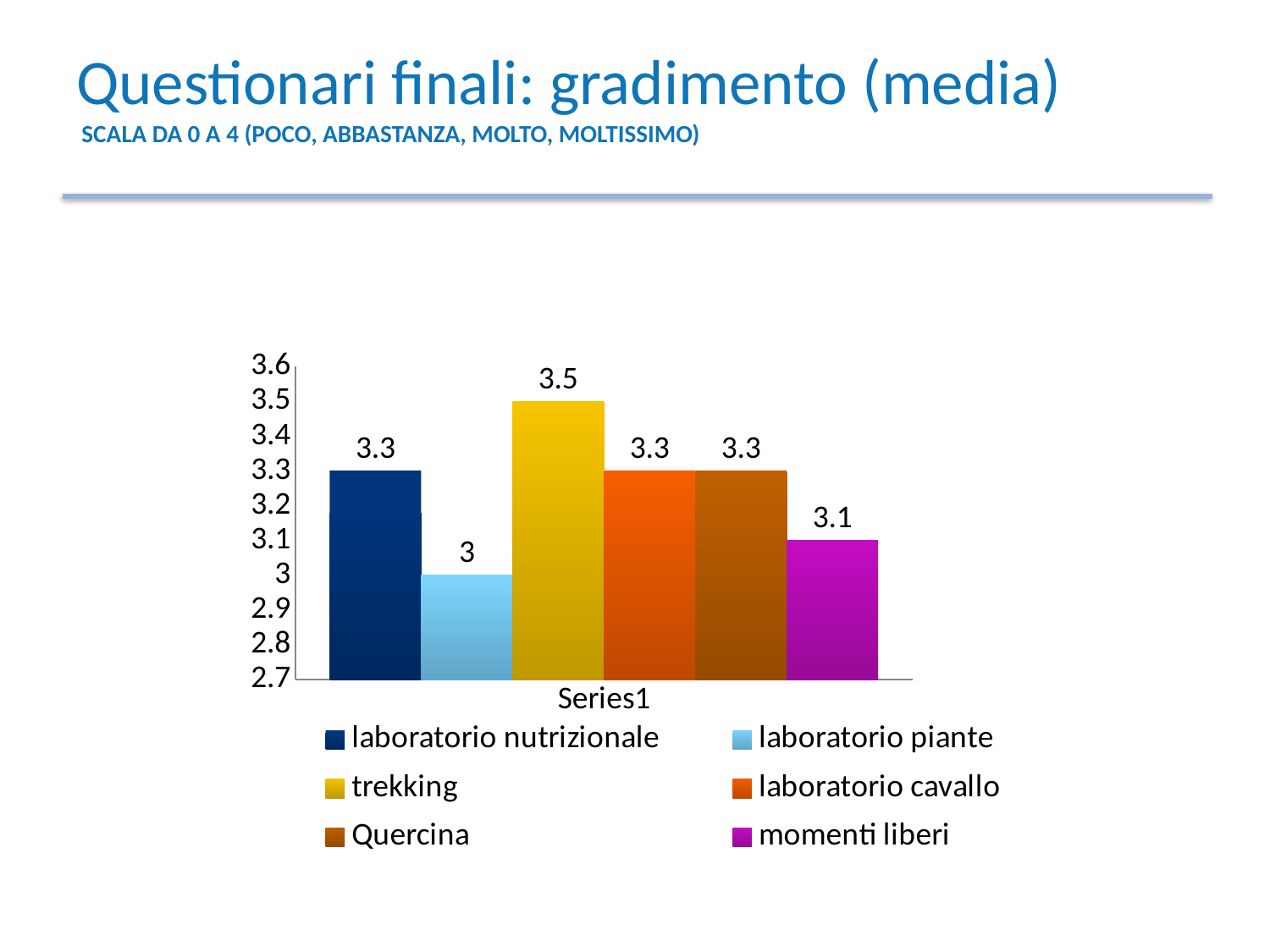
Which is larger, the value for laboratorio cavallo or the value for momenti liberi? laboratorio cavallo What is the title of the slide's chart section? Questionari finali: gradimento (media) What is the value for laboratorio piante? 3 What is the difference between the values for trekking and laboratorio piante? 0.5 Which activity has the highest value? trekking What kind of chart is shown on the slide? bar chart What is the difference between the values for Quercina and momenti liberi? 0.2 What is the value for trekking? 3.5 What is the value for momenti liberi? 3.1 Which activity has the lowest value? laboratorio piante How many series does the legend list? 6 What is the value for laboratorio nutrizionale? 3.3